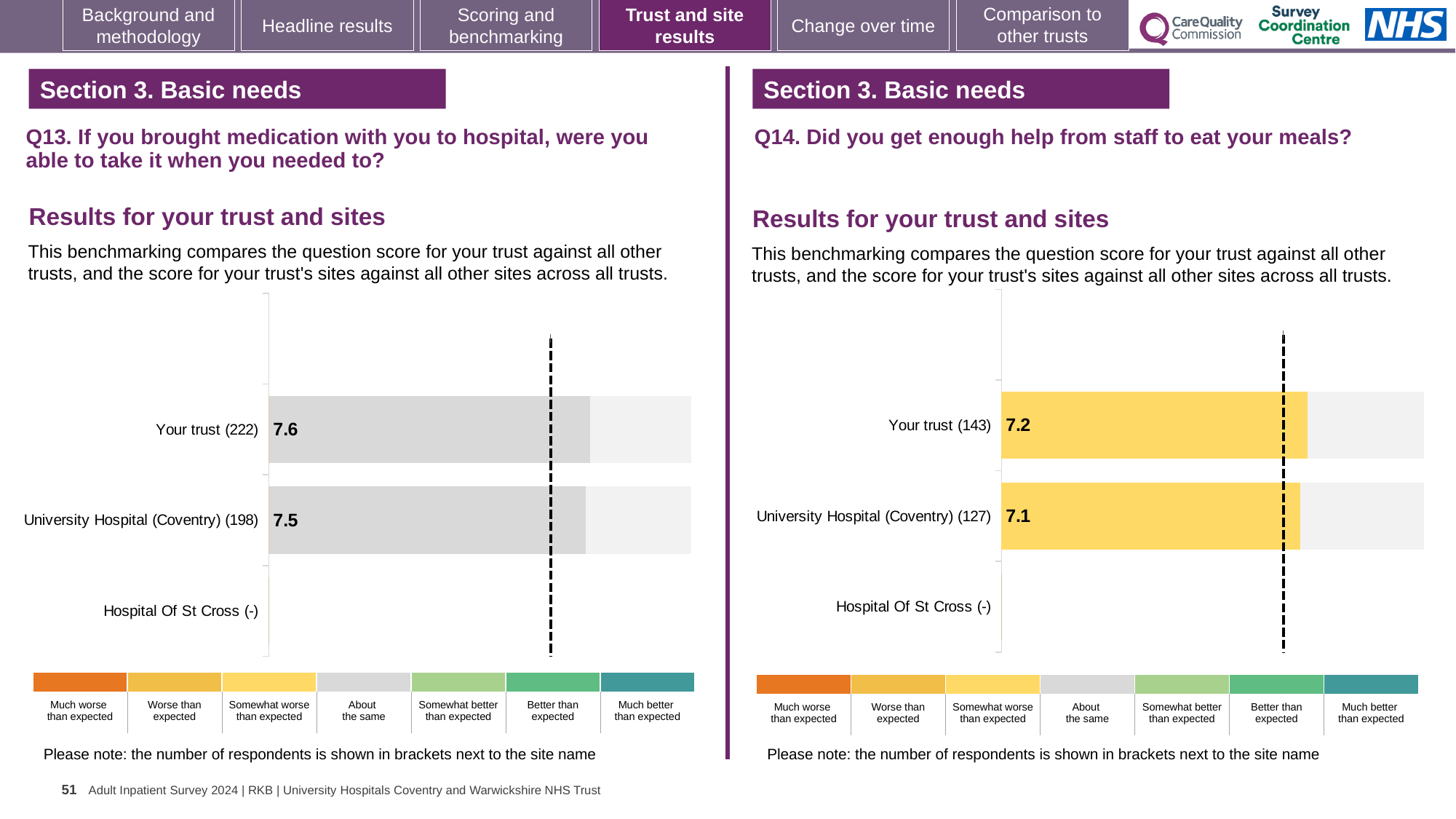
On the Q14 chart (right), which has the higher score, Your trust or University Hospital (Coventry)? Your trust On the Q13 chart (left), how many respondents are shown in brackets for Your trust? 222 On the Q14 chart (right), what is the score for University Hospital (Coventry)? 7.1 On the Q13 chart (left), which benchmark category does the grey bar colour represent according to the legend? About the same On the Q14 chart (right), how many respondents are shown in brackets for University Hospital (Coventry)? 127 How many site/trust categories are listed on the Q14 chart (right)? 3 On the Q13 chart (left), what is the score for University Hospital (Coventry)? 7.5 On the Q13 chart (left), what is the score for Your trust? 7.6 On the Q13 chart (left), what is the difference between the score for Your trust and the score for University Hospital (Coventry)? 0.1 What kind of chart is used on the Q13 chart (left)? Bar chart On the Q14 chart (right), which benchmark category does the yellow bar colour represent according to the legend? Somewhat worse than expected On the Q14 chart (right), what is the score for Your trust? 7.2